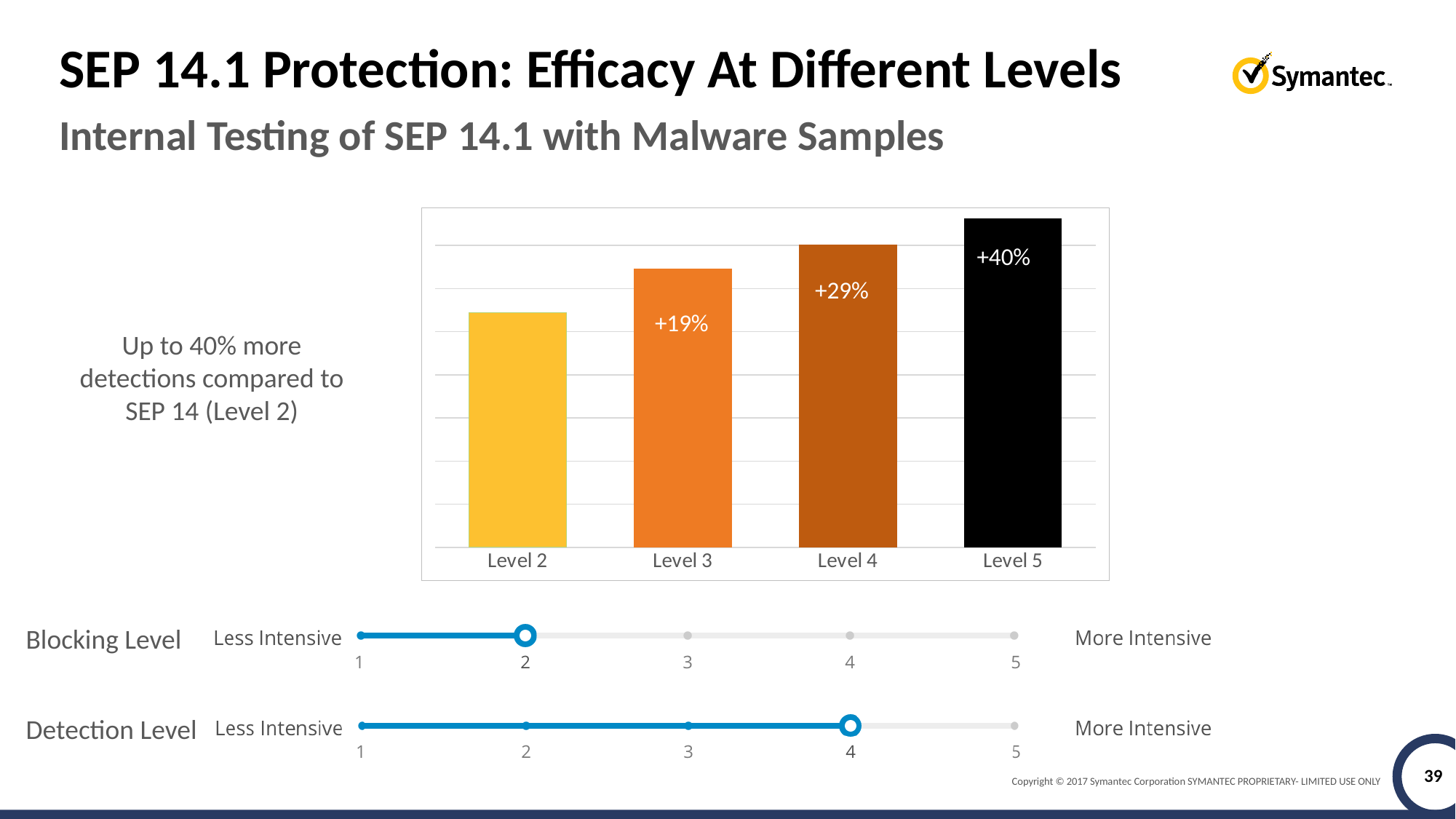
Do the bar heights rise or fall from Level 2 to Level 5? Rise Which level has the shortest bar in the chart? Level 2 What colour is the Level 5 bar? Black Which bar is taller, Level 4 or Level 3? Level 4 Which level has the tallest bar in the chart? Level 5 What kind of chart is shown on the slide? Bar chart What is the data label shown on the Level 3 bar? +19% What is the data label shown on the Level 4 bar? +29% What is the difference in percentage points between the labels on the Level 5 and Level 3 bars? 21 What is the data label shown on the Level 5 bar? +40% How many levels are plotted as bars in the chart? 4 What is the difference in percentage points between the labels on the Level 4 and Level 3 bars? 10